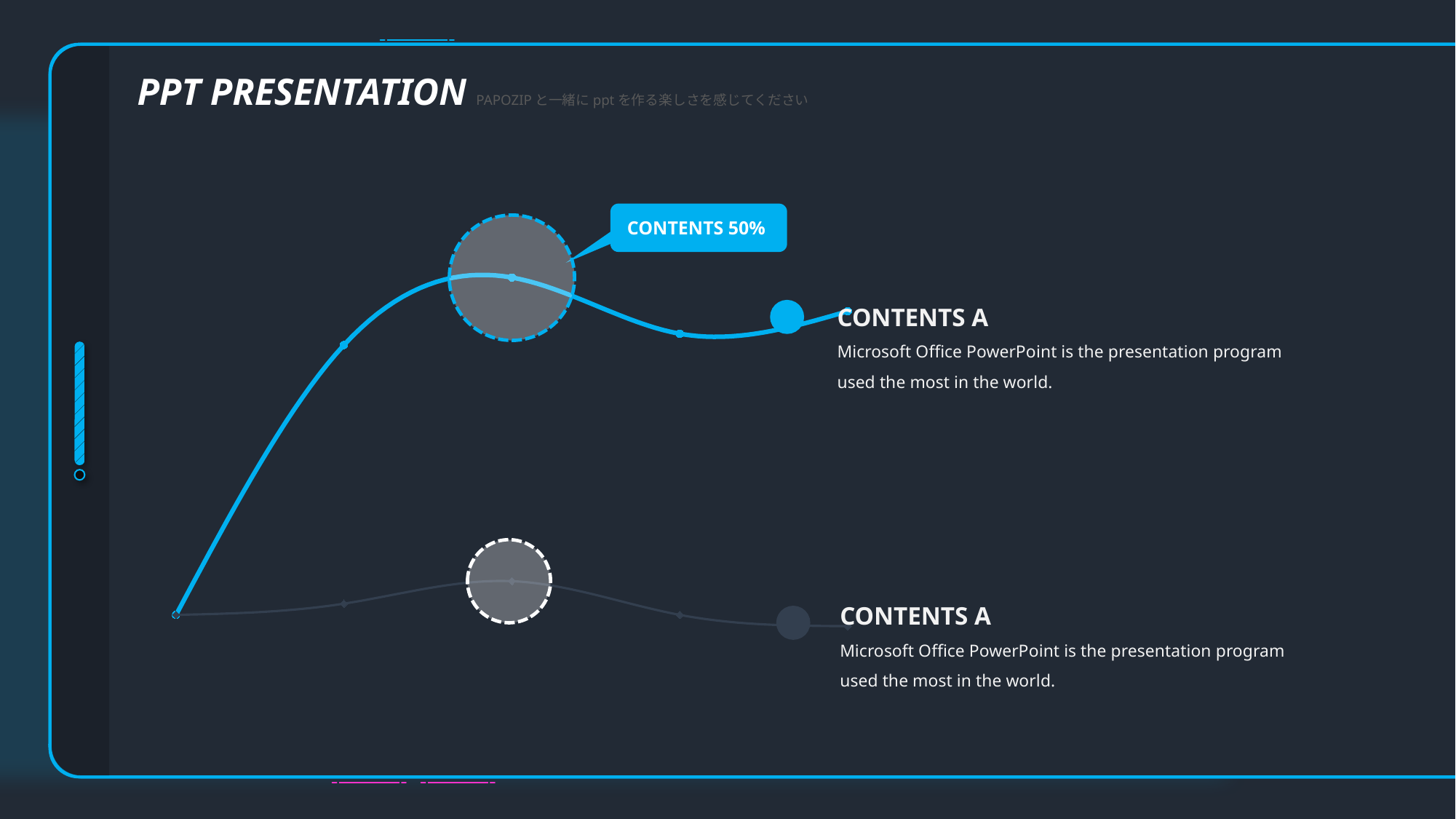
After its peak, does the blue line rise or fall toward the right end of the chart? fall What colour is the upper line on the chart? blue Which line reaches a higher peak, the blue line or the grey line? the blue line What kind of chart is shown on the slide? line chart Which line is plotted lower on the slide, the blue line or the grey line? the grey line What does the callout label attached to the upper line read? CONTENTS 50% Does the blue line rise or fall from its starting point on the left to its highest marked point? rise How many lines are plotted on the chart? 2